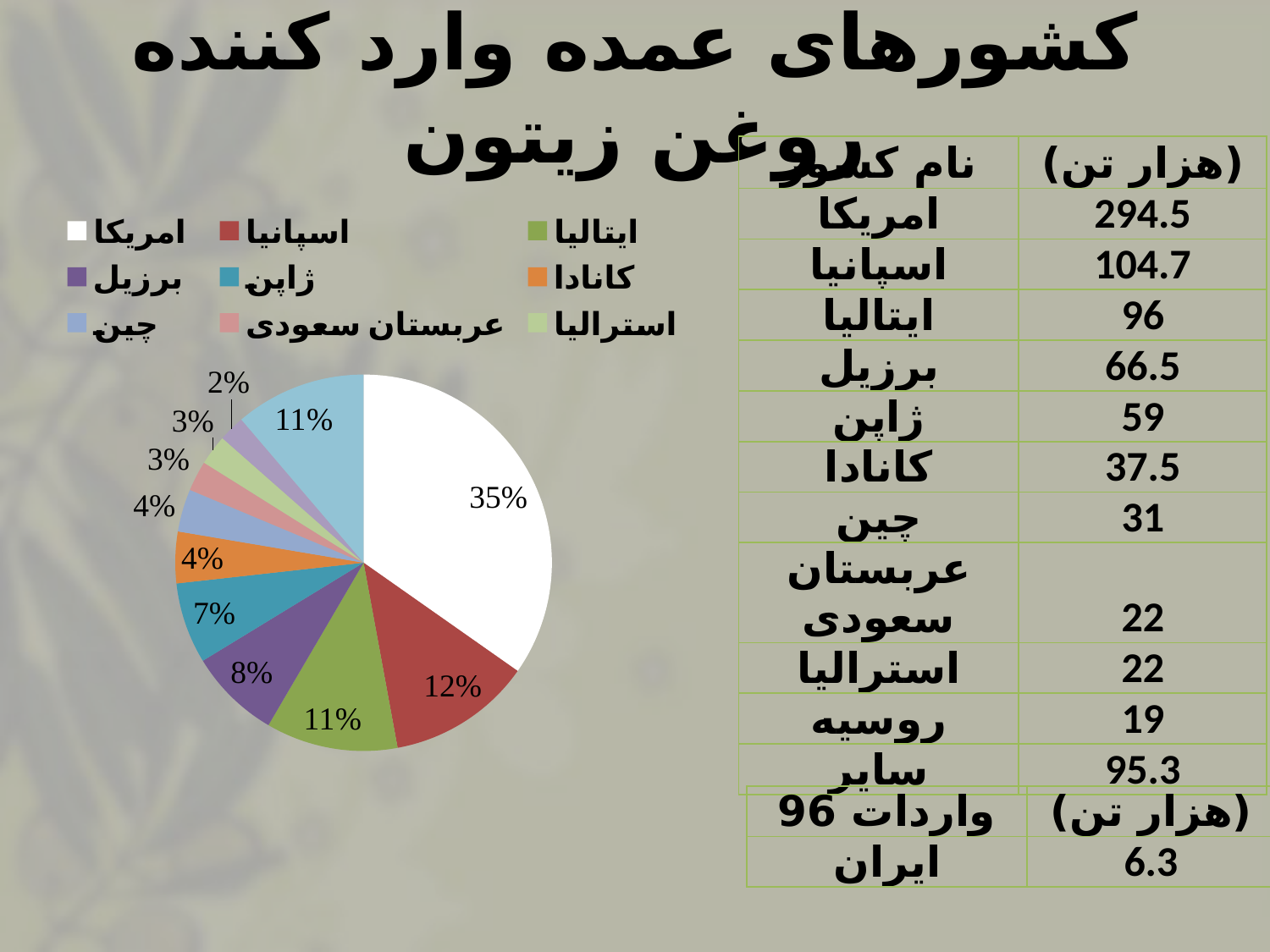
What percentage is shown for اسپانیا (the red slice)? 12% By how many percentage points does the امریکا slice exceed the اسپانیا slice? 23 What percentage is shown for ایتالیا (the green slice)? 11% What share of the pie does امریکا (the white slice) hold? 35% How many entries does the legend list? 9 How many slices does the pie chart have? 11 What percentage is shown for ژاپن (the teal slice)? 7% What percentage is shown for برزیل (the purple slice)? 8% What kind of chart is shown on the slide? pie chart Which country has the largest slice of the pie? امریکا Which slice is larger, اسپانیا or برزیل? اسپانیا What is the smallest percentage labelled on the pie chart? 2%